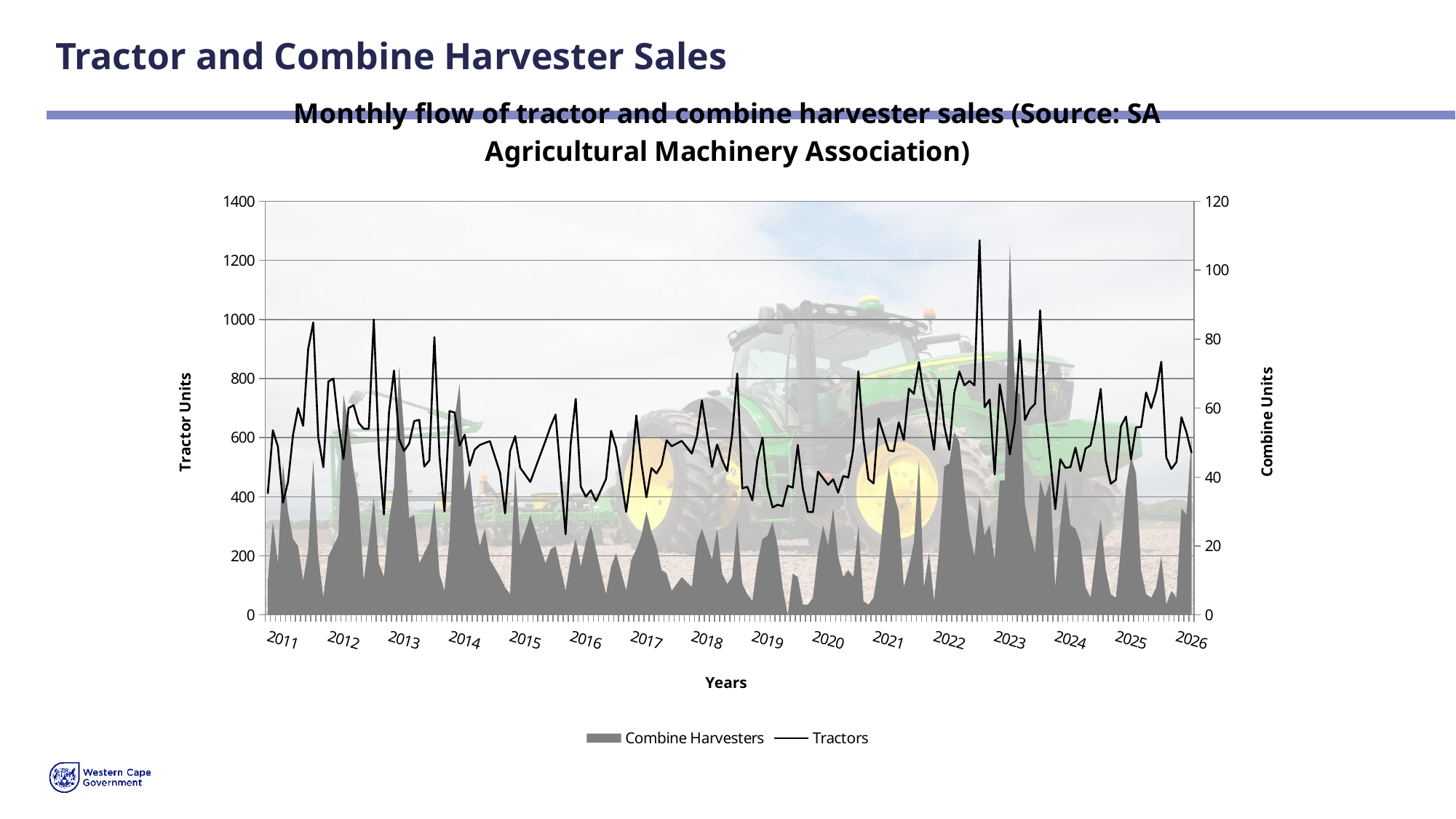
Is the highest value reached by the Combine Harvesters area greater or less than 100 on the right axis? greater What is the label of the left vertical axis? Tractor Units What is the highest tick value shown on the left vertical axis? 1400 Is the lowest value reached by the Tractors line greater or less than 400? less What is the label of the right vertical axis? Combine Units What kind of chart is shown on the slide? A combination chart with a shaded area series and a line series What is the highest tick value shown on the right vertical axis? 120 How many series does the legend list? 2 How many year labels are shown along the x axis? 16 Which series is plotted as a black line? Tractors Is the highest value reached by the Tractors line greater or less than 1200? greater